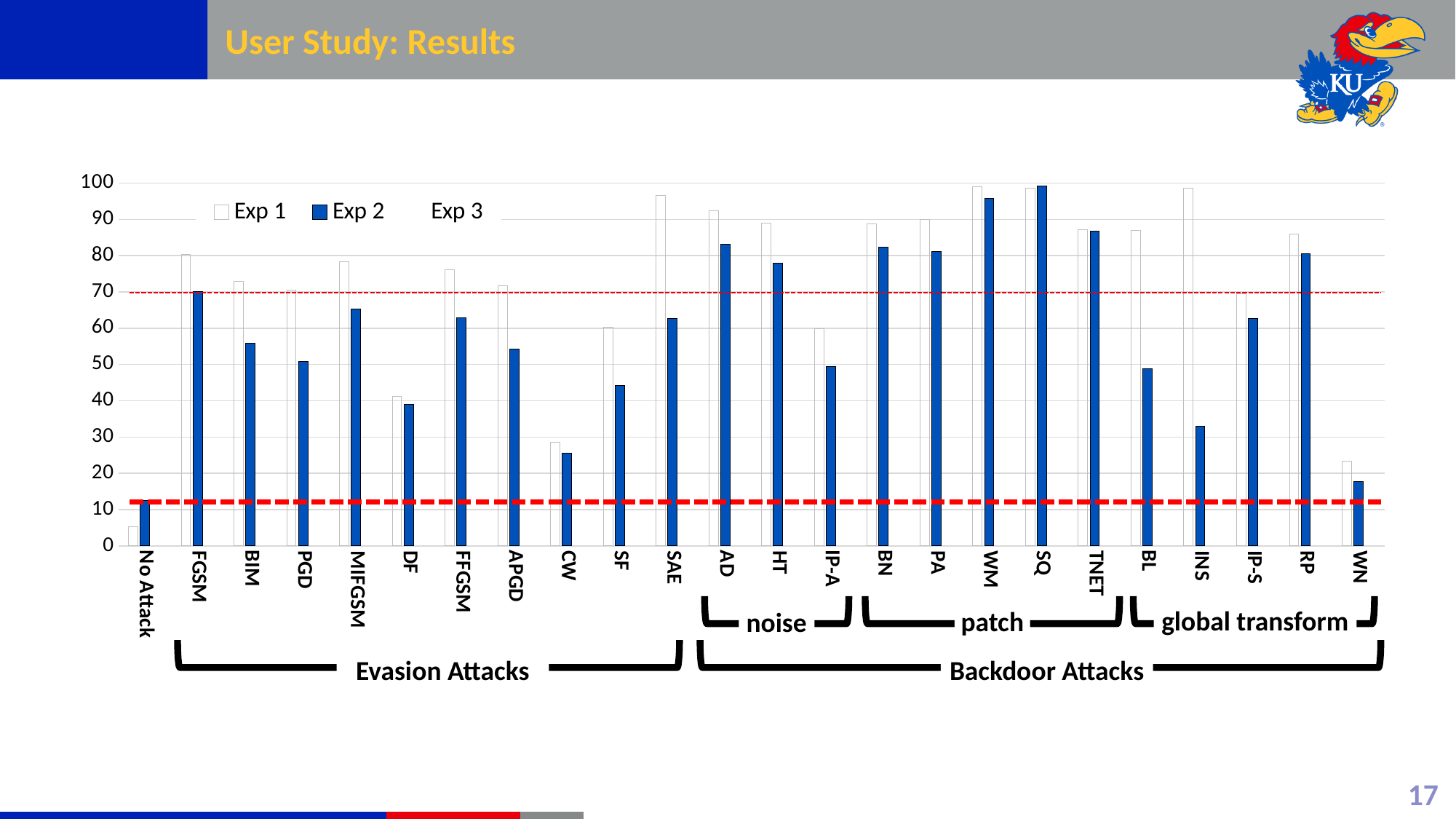
How many series does the legend list? 3 What colour are the Exp 2 bars? blue Which has the larger Exp 2 value, CW or SF? SF How many attack categories are shown along the x axis? 24 Is the Exp 2 value for BIM greater or less than 50? greater Which category has the lowest Exp 2 value? No Attack Which has the larger Exp 2 value, AD or IP-A? AD Is the Exp 2 value for WM greater or less than 90? greater What is the title of the slide containing the chart? User Study: Results Is the Exp 2 value for CW greater or less than 30? less What kind of chart is shown on the slide? bar chart